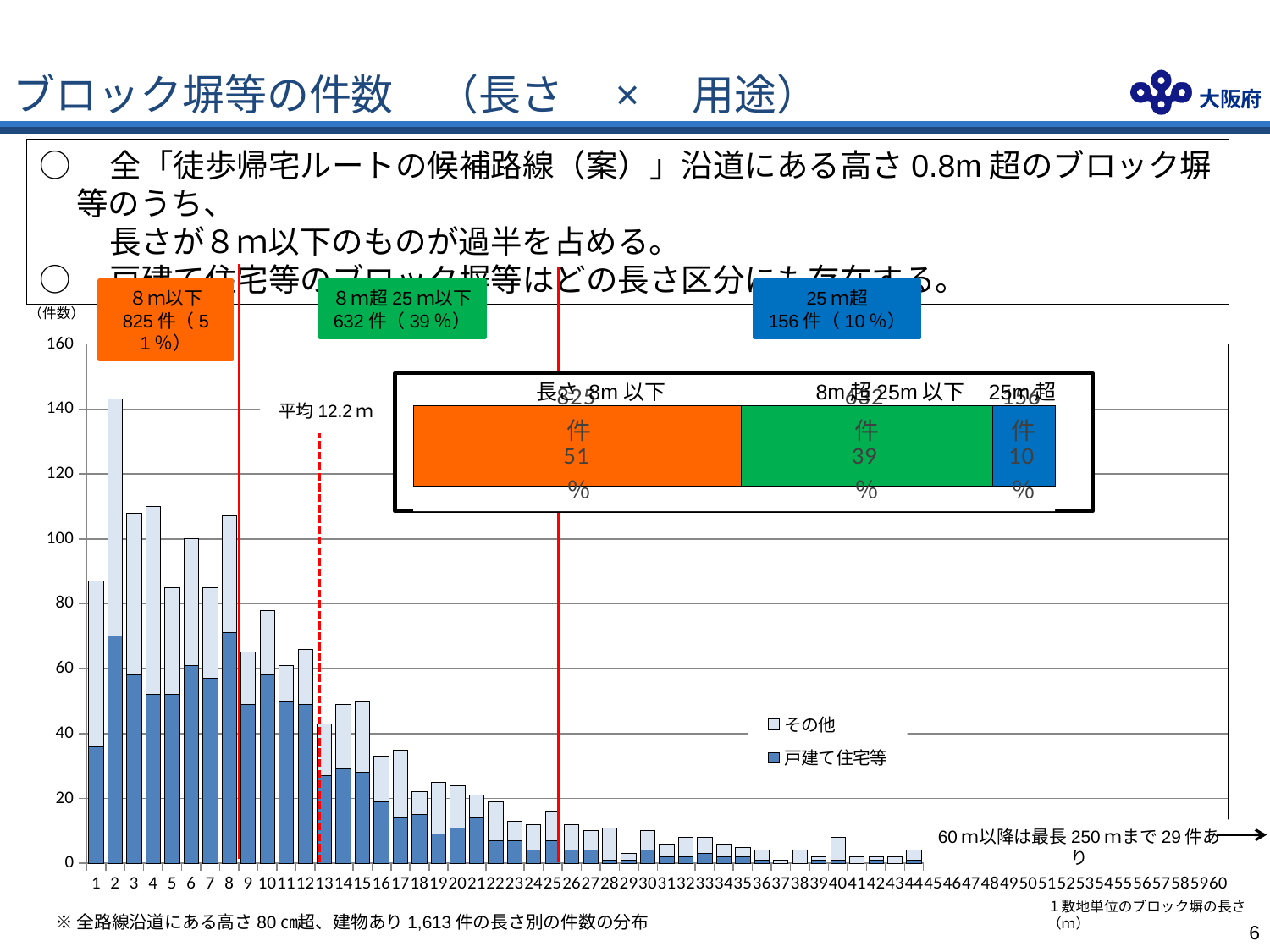
How many series does the legend of the main bar chart list? 2 In the main bar chart, which has the larger total: length 9 m or length 10 m? 10 m What are the two series named in the legend of the main bar chart? その他 and 戸建て住宅等 In the main bar chart, is the total value for length 13 m greater or less than 60? less In the inset horizontal stacked bar, how many cases are in the 長さ 8m 以下 category? 825 件 What kind of chart is the main chart on the slide? bar chart In the inset horizontal stacked bar, what is the total number of cases across the three length categories (825, 632 and 156)? 1,613 件 In the inset horizontal stacked bar, what share of cases is in the 8m 超 25m 以下 category? 39 % What average length is marked by the dashed line in the main bar chart? 平均 12.2 m In the main bar chart, is the total value for length 2 m greater or less than 120? greater In the main bar chart, which length category (m) has the highest total number of cases? 2 In the main bar chart, do the totals generally rise or fall as the length increases beyond 2 m? fall